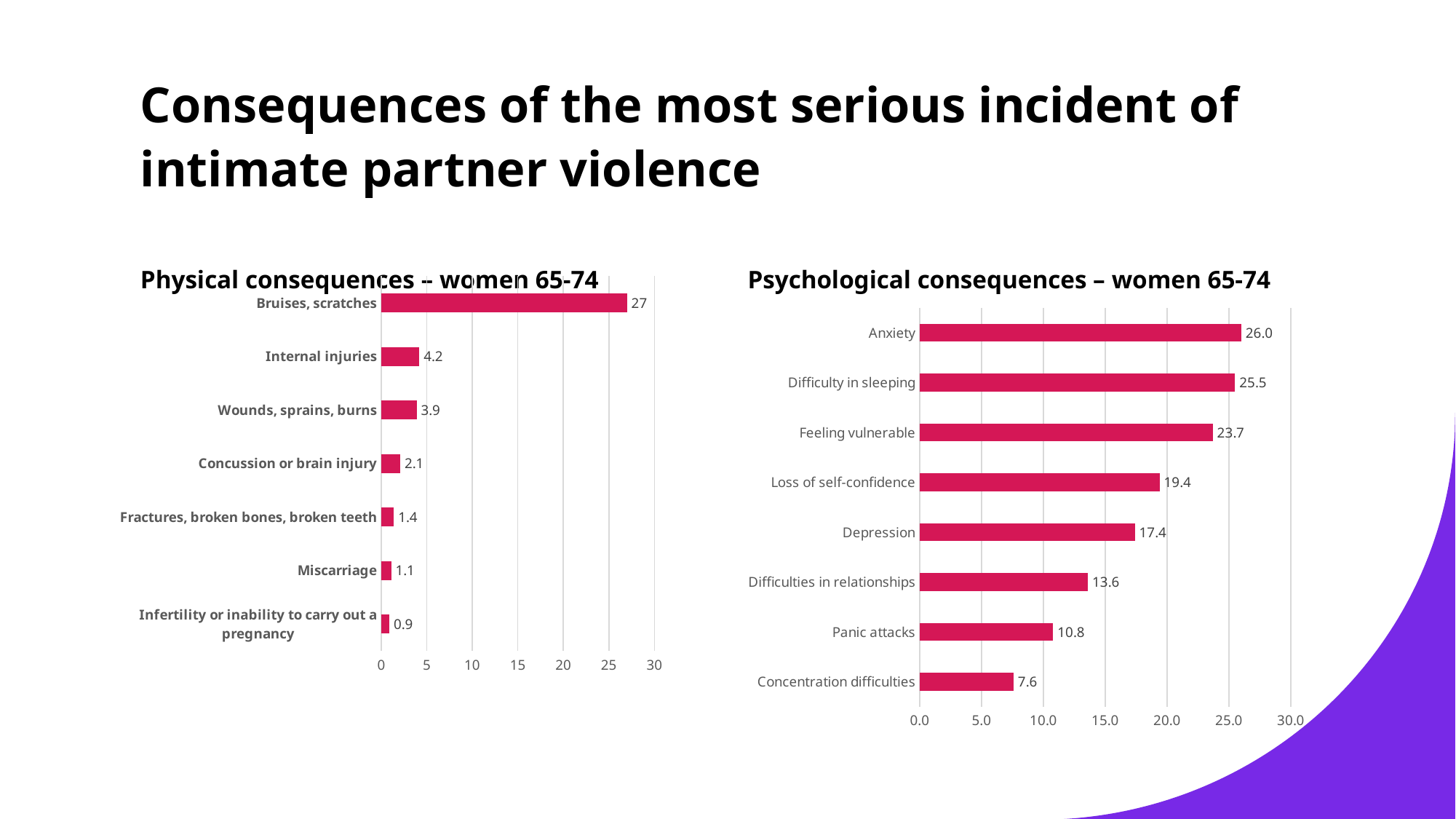
In the 'Physical consequences - women 65-74' chart, what is the difference between Internal injuries and Wounds, sprains, burns? 0.3 In the 'Physical consequences - women 65-74' chart, how many categories are shown? 7 In the 'Physical consequences - women 65-74' chart, what is the value for Concussion or brain injury? 2.1 In the 'Physical consequences - women 65-74' chart, what is the value for Bruises, scratches? 27 In the 'Psychological consequences – women 65-74' chart, what is the value for Depression? 17.4 In the 'Physical consequences - women 65-74' chart, which category has the lowest value? Infertility or inability to carry out a pregnancy In the 'Psychological consequences – women 65-74' chart, which category has the highest value? Anxiety In the 'Psychological consequences – women 65-74' chart, which is larger: Loss of self-confidence or Difficulties in relationships? Loss of self-confidence In the 'Psychological consequences – women 65-74' chart, what is the difference between Anxiety and Panic attacks? 15.2 In the 'Physical consequences - women 65-74' chart, is the value for Bruises, scratches greater or less than 25? greater In the 'Psychological consequences – women 65-74' chart, which category has the lowest value? Concentration difficulties What type of chart is the 'Psychological consequences – women 65-74' chart? Bar chart